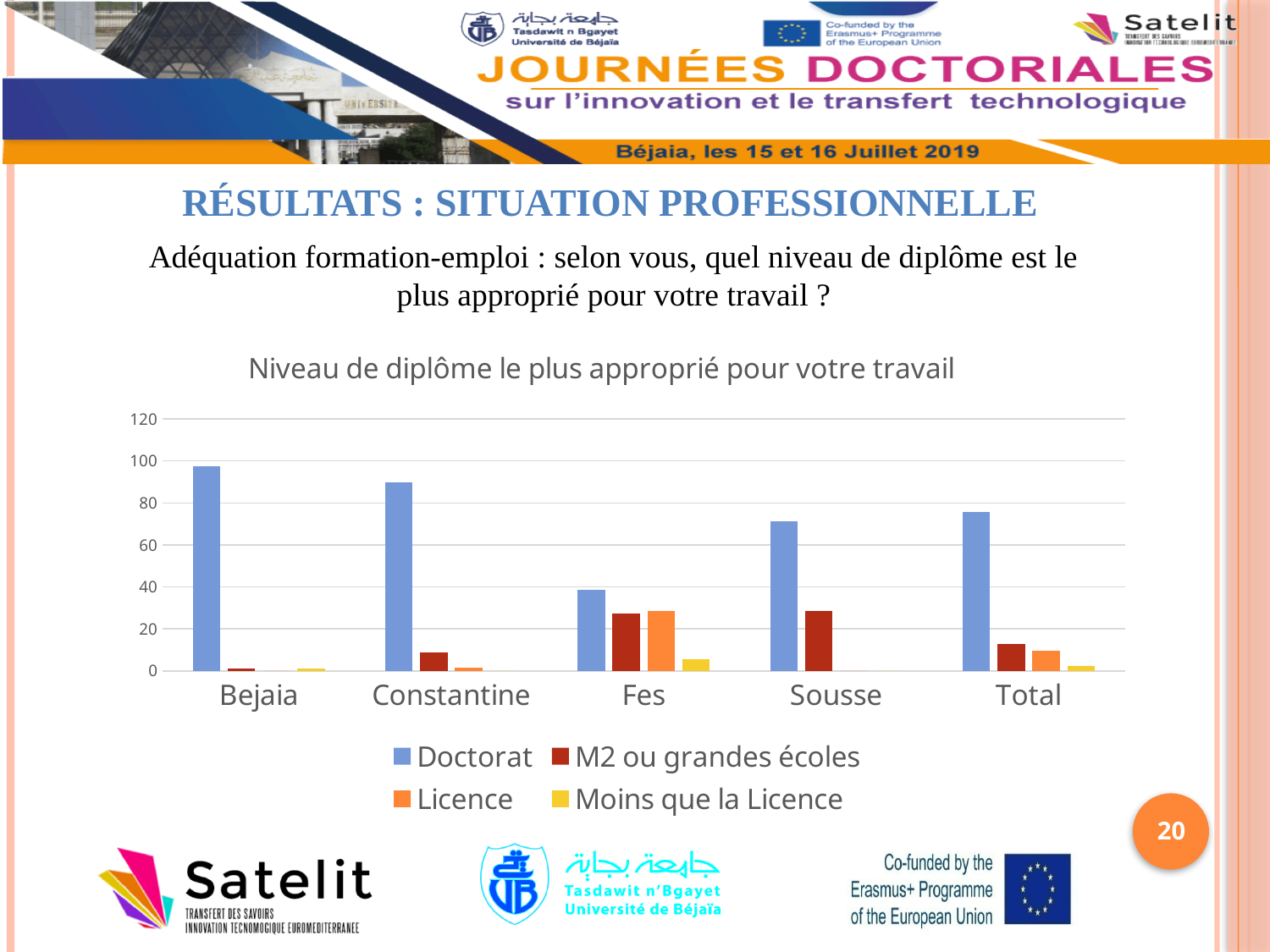
Which is larger, the M2 ou grandes écoles value for Sousse or for Constantine? Sousse Is the Doctorat value for Bejaia greater or less than 80? greater Which category has the lowest Doctorat bar? Fes Is the Doctorat value for Total greater or less than 60? greater In the Fes category, which series has the tallest bar? Doctorat Is the Doctorat value for Fes greater or less than 60? less Which is larger, the Doctorat value for Constantine or for Sousse? Constantine How many series does the chart's legend list? 4 How many categories are shown on the x axis of the chart? 5 What kind of chart is shown on the slide? Bar chart Which category has the highest Doctorat bar? Bejaia What is the title of the chart? Niveau de diplôme le plus approprié pour votre travail